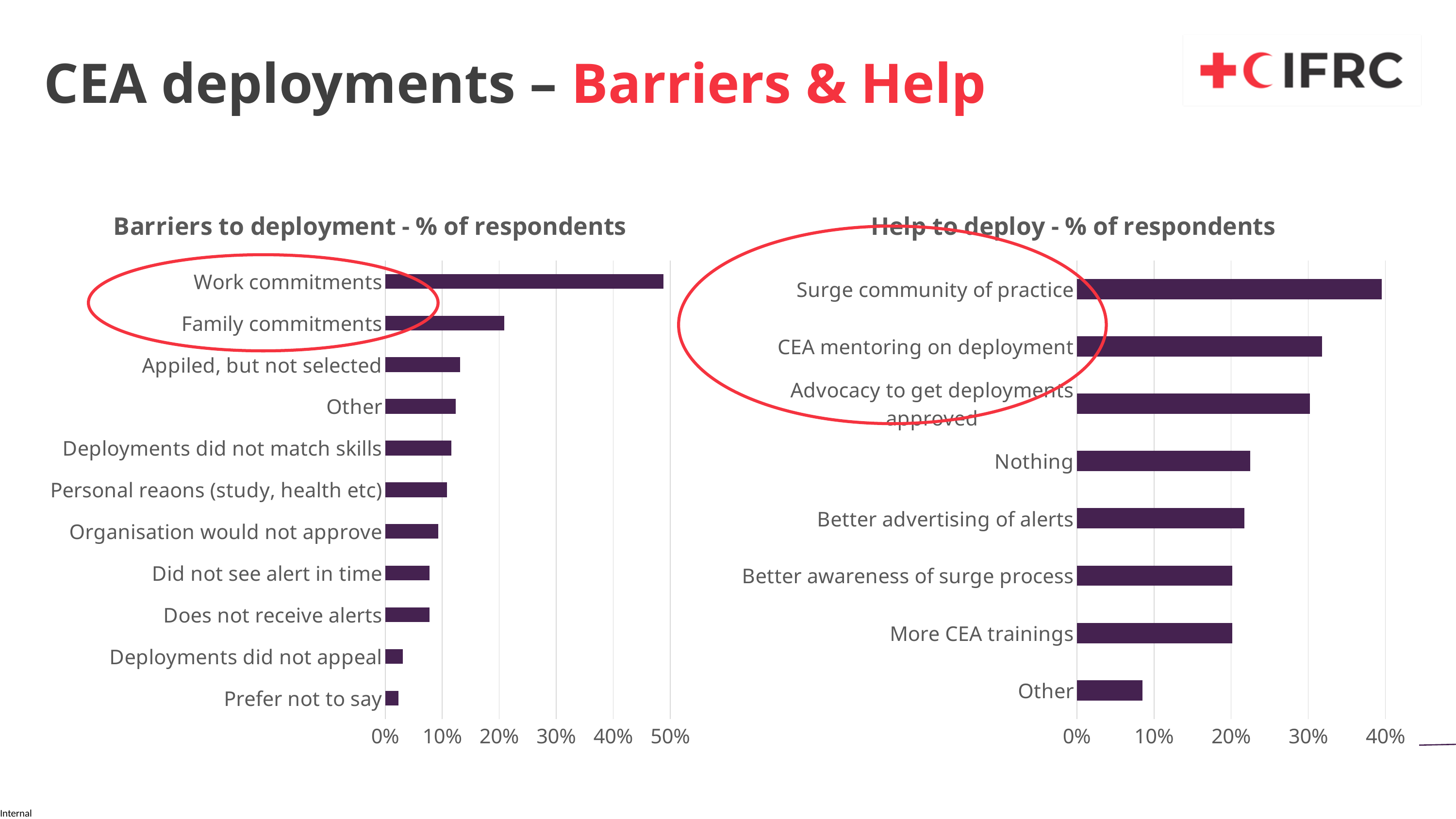
In the 'Help to deploy - % of respondents' chart, which option has the highest percentage of respondents? Surge community of practice In the 'Help to deploy - % of respondents' chart, is the value for Surge community of practice greater or less than 30%? greater In the 'Barriers to deployment - % of respondents' chart, which is larger: Work commitments or Family commitments? Work commitments How many categories are shown in the 'Help to deploy - % of respondents' chart? 8 What type of chart is the 'Barriers to deployment - % of respondents' chart? bar chart In the 'Help to deploy - % of respondents' chart, is the value for Other greater or less than 10%? less In the 'Barriers to deployment - % of respondents' chart, is the value for Family commitments greater or less than 30%? less In the 'Barriers to deployment - % of respondents' chart, which barrier has the highest percentage of respondents? Work commitments How many categories are shown in the 'Barriers to deployment - % of respondents' chart? 11 In the 'Help to deploy - % of respondents' chart, which option has the lowest percentage of respondents? Other In the 'Help to deploy - % of respondents' chart, which is larger: Surge community of practice or Nothing? Surge community of practice